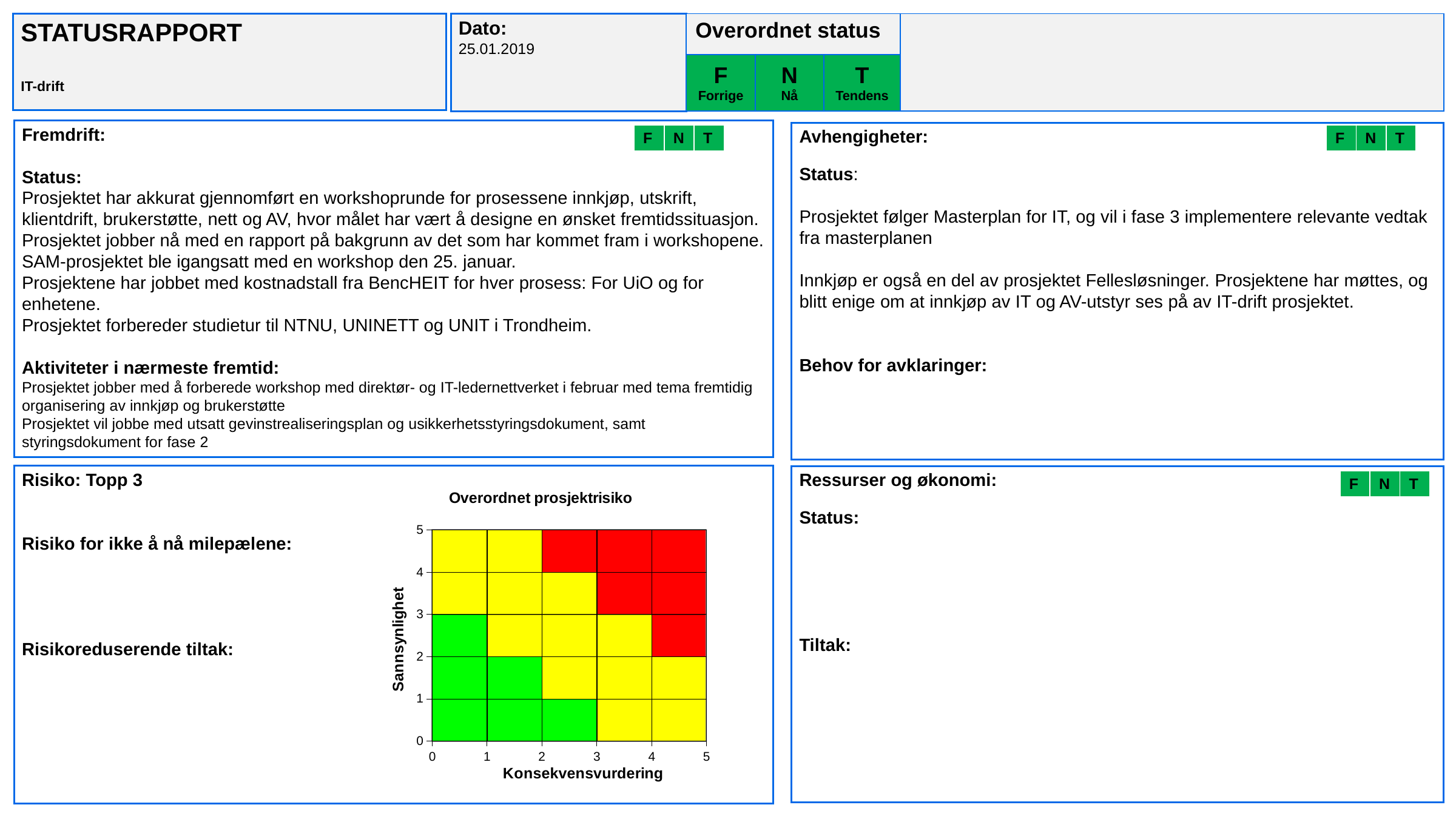
How many green cells are there in the Overordnet prosjektrisiko chart? 6 In the Overordnet prosjektrisiko chart, what colour is the cell in the bottom-left corner (Konsekvensvurdering 0–1, Sannsynlighet 0–1)? Green How many red cells are there in the Overordnet prosjektrisiko chart? 6 In the Overordnet prosjektrisiko chart, what colour is the cell at Konsekvensvurdering 4–5, Sannsynlighet 0–1? Yellow What is the label of the horizontal axis of the Overordnet prosjektrisiko chart? Konsekvensvurdering What kind of chart is Overordnet prosjektrisiko? Risk matrix (heat map) In the Overordnet prosjektrisiko chart, what colour is the cell in the top-right corner (Konsekvensvurdering 4–5, Sannsynlighet 4–5)? Red How many different colours are used in the cells of the Overordnet prosjektrisiko chart? 3 What is the highest value shown on the Konsekvensvurdering axis of the Overordnet prosjektrisiko chart? 5 What is the title of the chart in the Risiko: Topp 3 section? Overordnet prosjektrisiko What is the highest value shown on the Sannsynlighet axis of the Overordnet prosjektrisiko chart? 5